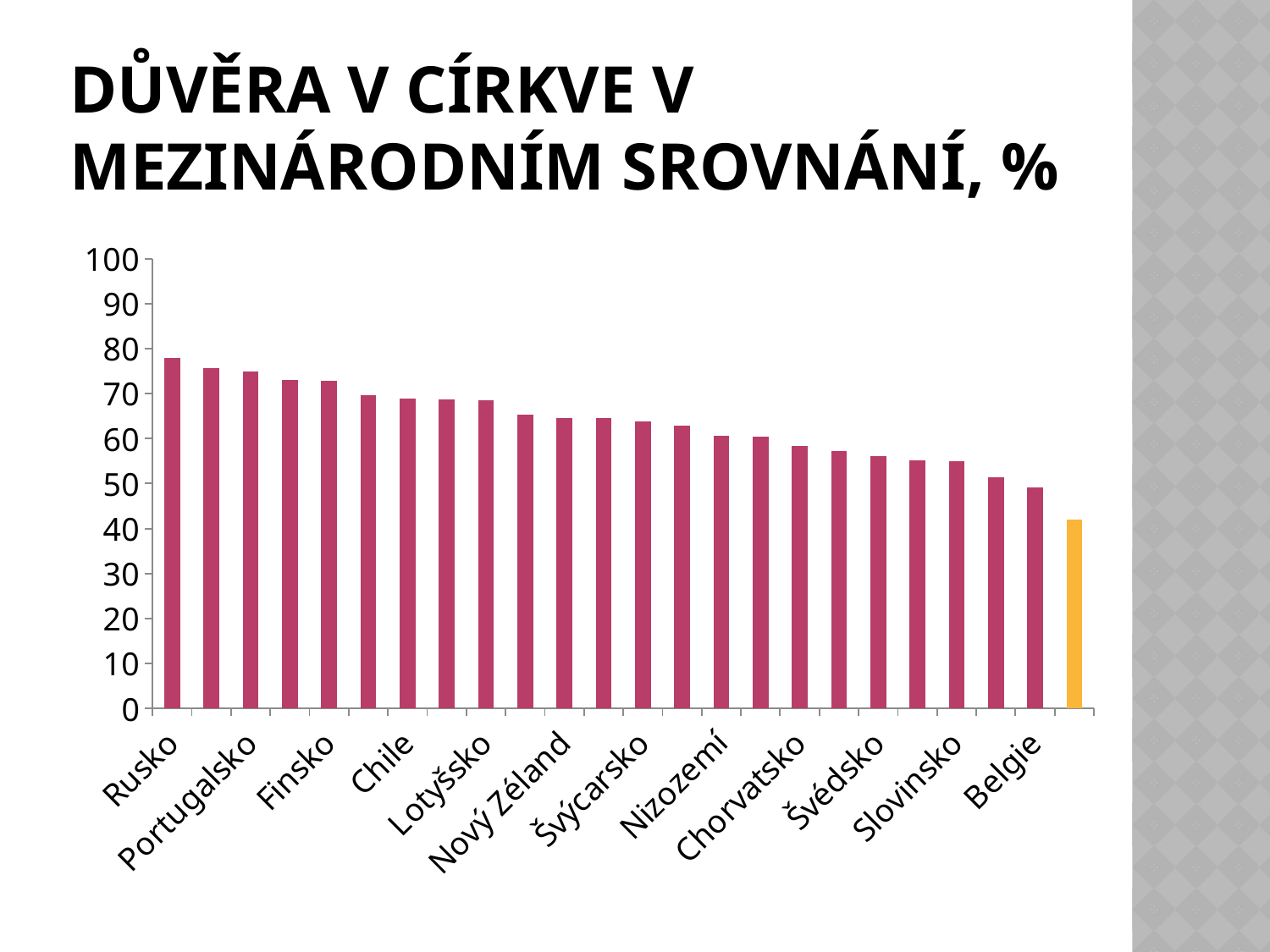
Which has the larger value, Rusko or Belgie? Rusko Which labelled country has the highest value in the chart? Rusko Do the bar values rise or fall from left to right across the chart? fall Is the value for Belgie greater or less than 60? less Is the value of the yellow bar at the far right greater or less than 50? less What kind of chart is shown on the slide? bar chart Which has the larger value, Finsko or Slovinsko? Finsko Is the value for Chile greater or less than 60? greater What colour is the last bar on the right of the chart? yellow